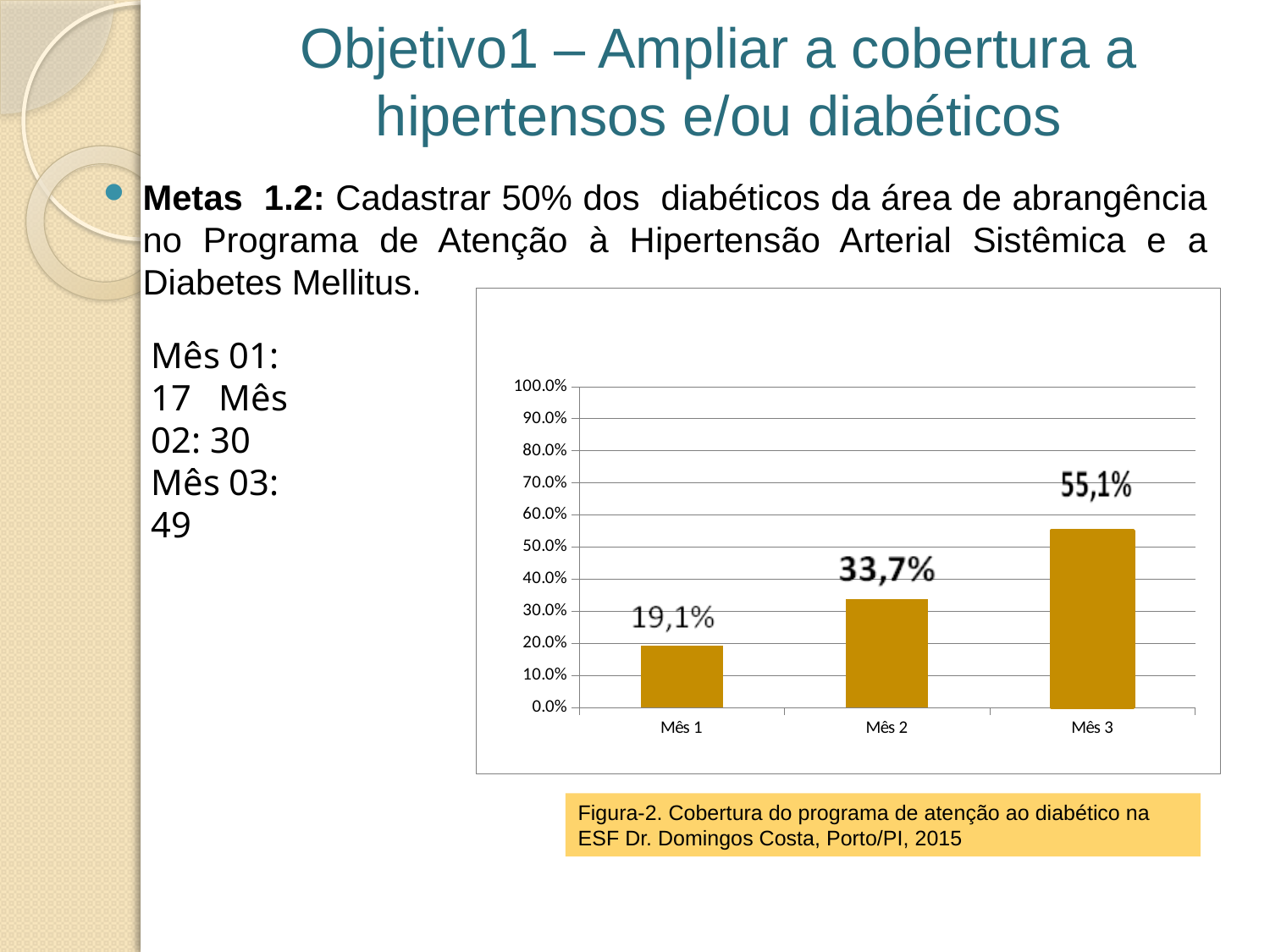
Which month has the lowest value? Mês 1 Do the values rise or fall from Mês 1 to Mês 3? rise What is the value for Mês 3? 55,1% What is the value for Mês 2? 33,7% What is the difference between the values for Mês 3 and Mês 1? 36,0% What is the difference between the values for Mês 2 and Mês 1? 14,6% What is the value for Mês 1? 19,1% Is the value for Mês 3 greater or less than 50.0%? greater Which is larger, the value for Mês 2 or the value for Mês 3? Mês 3 What kind of chart is shown? bar chart How many months are shown on the x axis? 3 Which month has the highest value? Mês 3